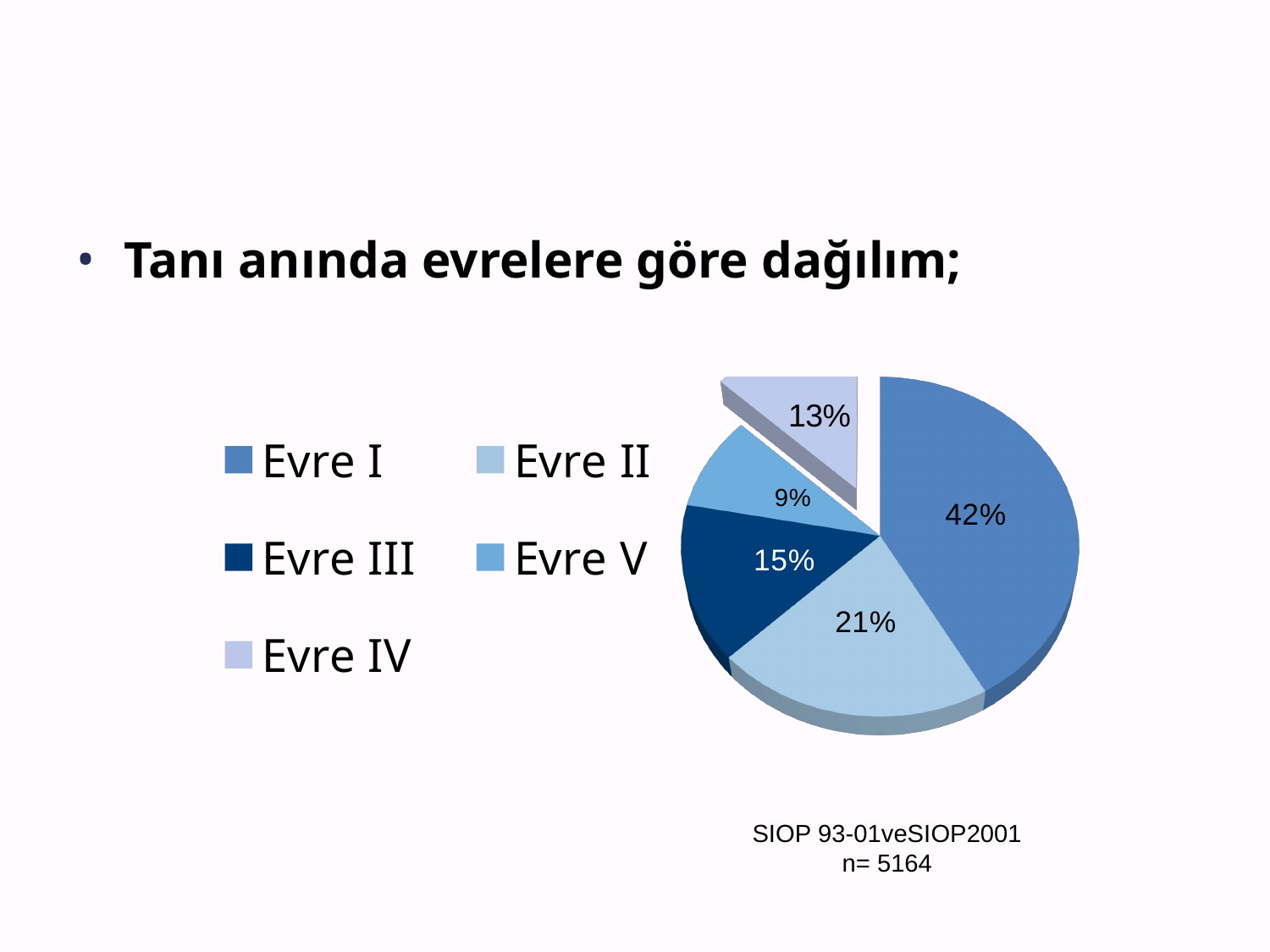
What is the difference in percentage points between Evre I and Evre II? 21 What type of chart is shown on the slide? Pie chart Which stage (Evre) has the smallest share of the pie chart? Evre V How many slices does the pie chart have? 5 What sample size (n) is given below the pie chart? n= 5164 What percentage of the pie chart is Evre IV? 13% What percentage of the pie chart is Evre II? 21% What percentage of the pie chart is Evre V? 9% What percentage of the pie chart is Evre III? 15% Which stage (Evre) has the largest share of the pie chart? Evre I What percentage of the pie chart is Evre I? 42% Which has a larger share, Evre III or Evre IV? Evre III